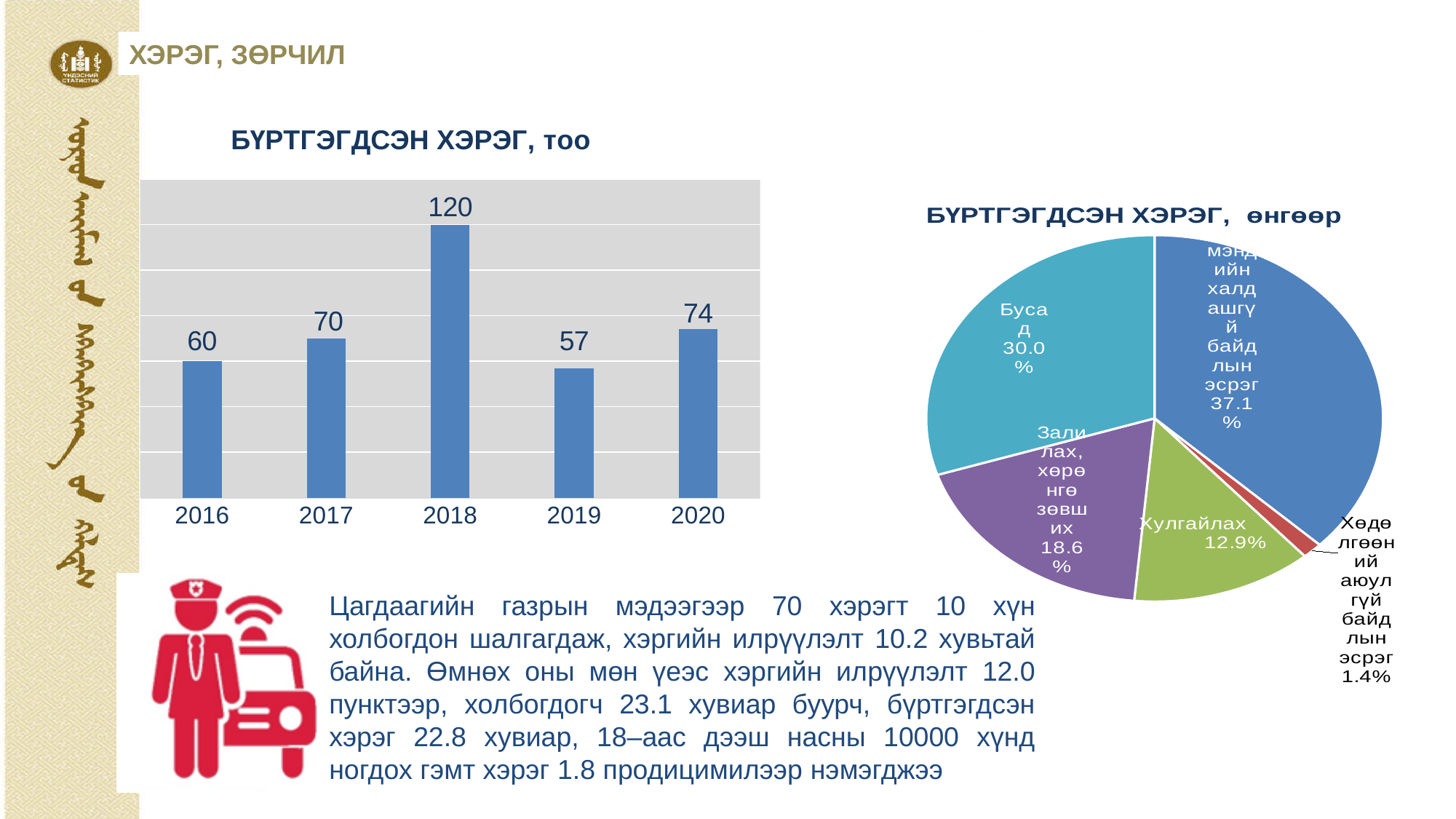
In the bar chart 'БҮРТГЭГДСЭН ХЭРЭГ, тоо', which year has the highest value? 2018 In the bar chart 'БҮРТГЭГДСЭН ХЭРЭГ, тоо', what is the difference between the values for 2018 and 2019? 63 In the pie chart 'БҮРТГЭГДСЭН ХЭРЭГ, өнгөөр', what share does 'Хулгайлах' have? 12.9% In the bar chart 'БҮРТГЭГДСЭН ХЭРЭГ, тоо', which is larger, the value for 2017 or the value for 2020? 2020 In the bar chart 'БҮРТГЭГДСЭН ХЭРЭГ, тоо', did the value rise or fall from 2018 to 2019? fall In the pie chart 'БҮРТГЭГДСЭН ХЭРЭГ, өнгөөр', what share does 'Бусад' have? 30.0% In the bar chart 'БҮРТГЭГДСЭН ХЭРЭГ, тоо', which year has the lowest value? 2019 In the bar chart 'БҮРТГЭГДСЭН ХЭРЭГ, тоо', what is the value for 2020? 74 In the pie chart 'БҮРТГЭГДСЭН ХЭРЭГ, өнгөөр', which slice is the smallest? Хөдөлгөөний аюулгүй байдлын эсрэг In the bar chart 'БҮРТГЭГДСЭН ХЭРЭГ, тоо', what is the value for 2018? 120 What kind of chart is 'БҮРТГЭГДСЭН ХЭРЭГ, тоо'? bar chart How many years are shown in the bar chart 'БҮРТГЭГДСЭН ХЭРЭГ, тоо'? 5